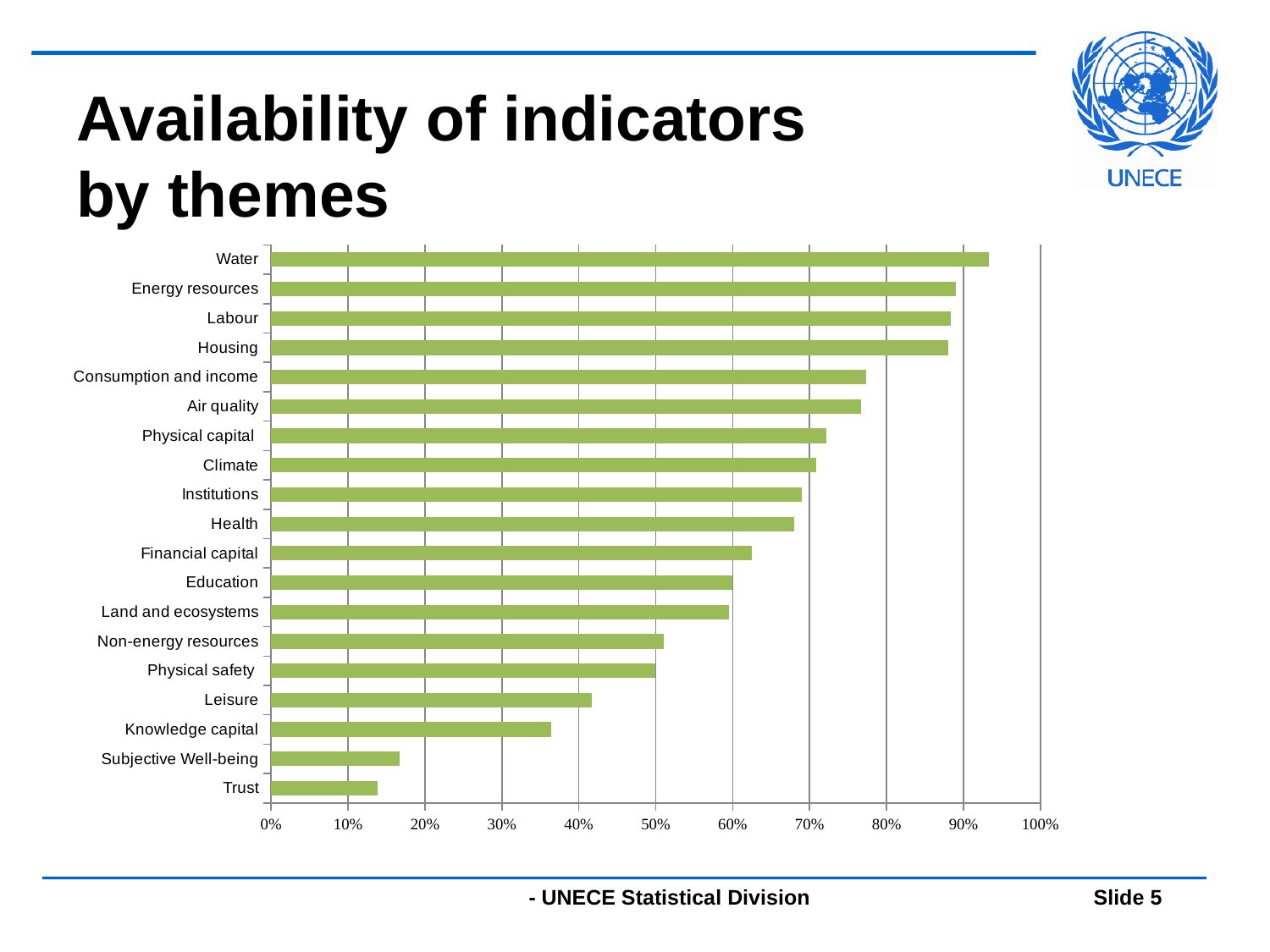
Is the value for Knowledge capital greater or less than 40%? less Which theme has the lowest availability of indicators? Trust Which has a higher value, Health or Leisure? Health How many themes (categories) are plotted in the chart? 19 Is the value for Trust greater or less than 20%? less Is the value for Subjective Well-being greater or less than 20%? less What kind of chart is shown on the slide? bar chart What is the title of the slide containing the chart? Availability of indicators by themes Which has a higher value, Climate or Knowledge capital? Climate Which theme has the highest availability of indicators? Water